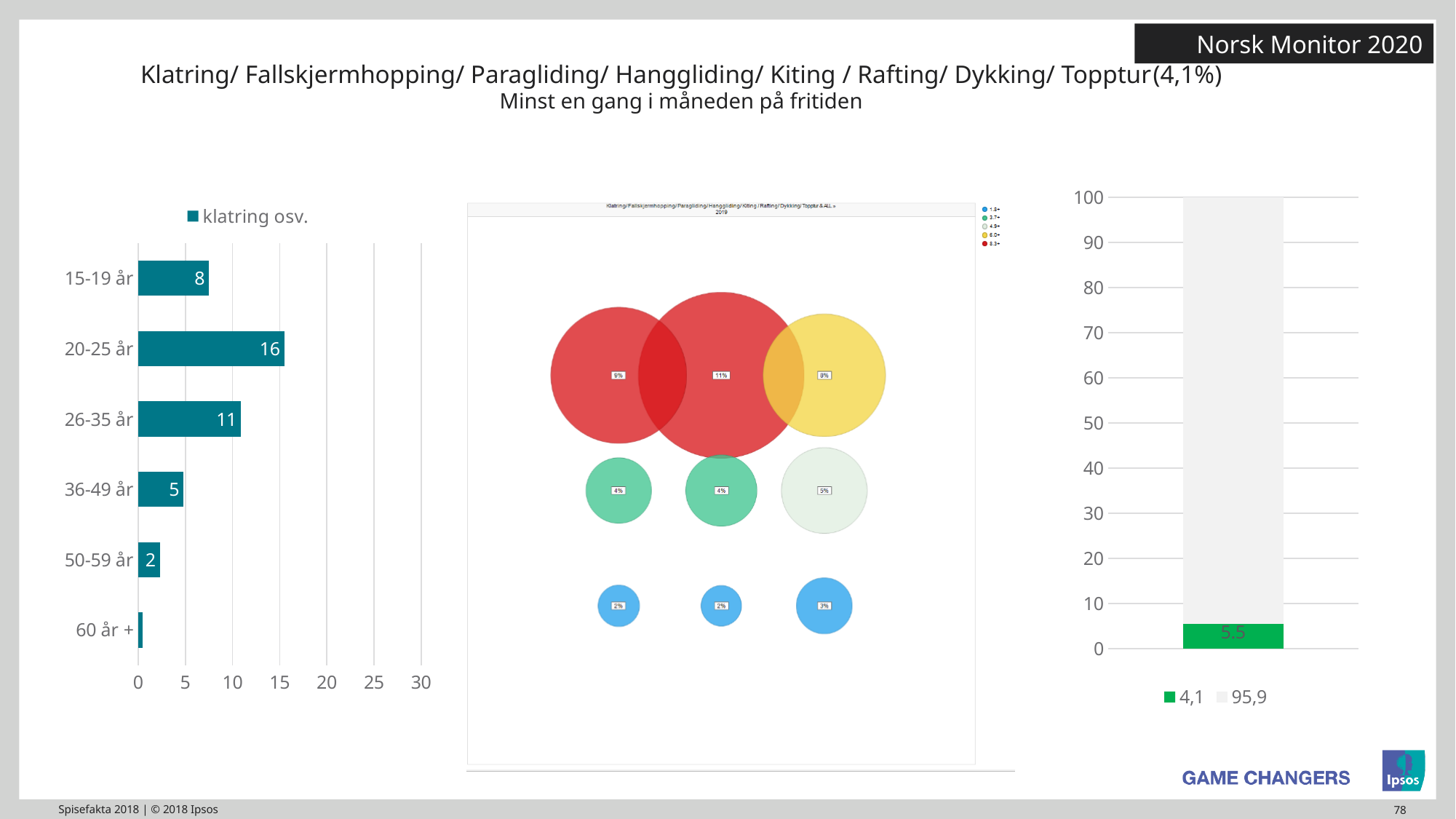
How many series does the legend of the right-hand stacked bar chart list? 2 In the left bar chart, which age group has the highest value? 20-25 år In the right-hand stacked bar chart, what value is printed on the green segment? 5.5 In the left bar chart, what is the value for 26-35 år? 11 How many age groups are shown in the left bar chart? 6 In the left bar chart, what is the value for 20-25 år? 16 In the left bar chart, which age group has the lowest value? 60 år + What type of chart is the chart on the left of the slide? bar chart In the left bar chart, which is larger: the value for 36-49 år or the value for 26-35 år? 26-35 år In the left bar chart, is the value for 60 år + greater or less than 5? less In the left bar chart, what is the value for 50-59 år? 2 In the left bar chart, what is the difference between the values for 20-25 år and 15-19 år? 8